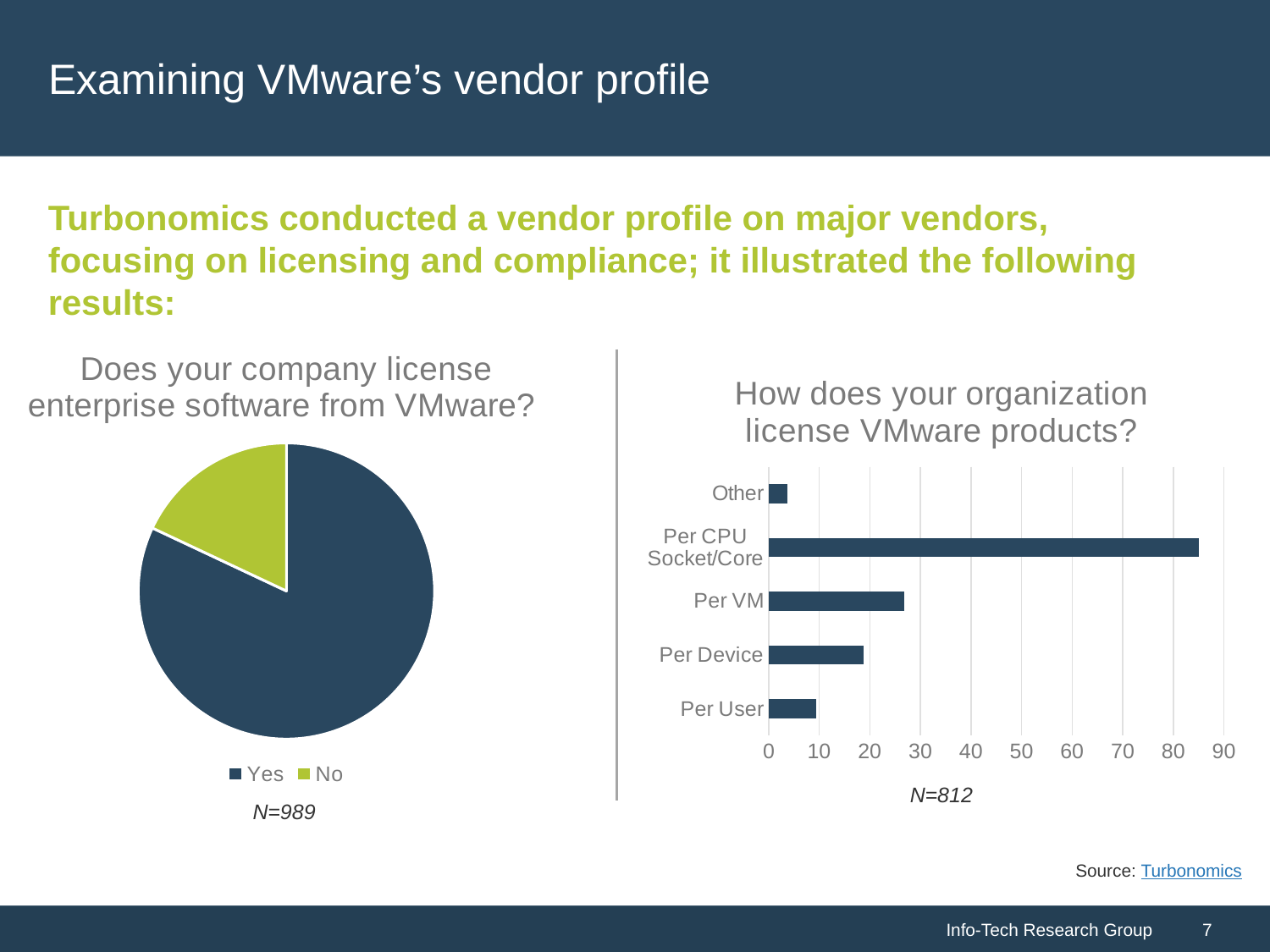
In the bar chart on the right, which category has the lowest value? Other In the bar chart on the right, which category has the highest value? Per CPU Socket/Core In the bar chart on the right, is the value for Per CPU Socket/Core greater or less than 80? greater How many categories are shown in the bar chart on the right? 5 What sample size (N) is shown below the bar chart on the right? N=812 How many entries does the legend of the pie chart on the left list? 2 In the pie chart on the left, which slice is larger, Yes or No? Yes What kind of chart is the chart titled "Does your company license enterprise software from VMware?"? pie chart In the bar chart on the right, is the value for Per VM greater or less than 30? less In the bar chart on the right, which is larger, the value for Per VM or the value for Per Device? Per VM What kind of chart is the chart titled "How does your organization license VMware products?"? bar chart